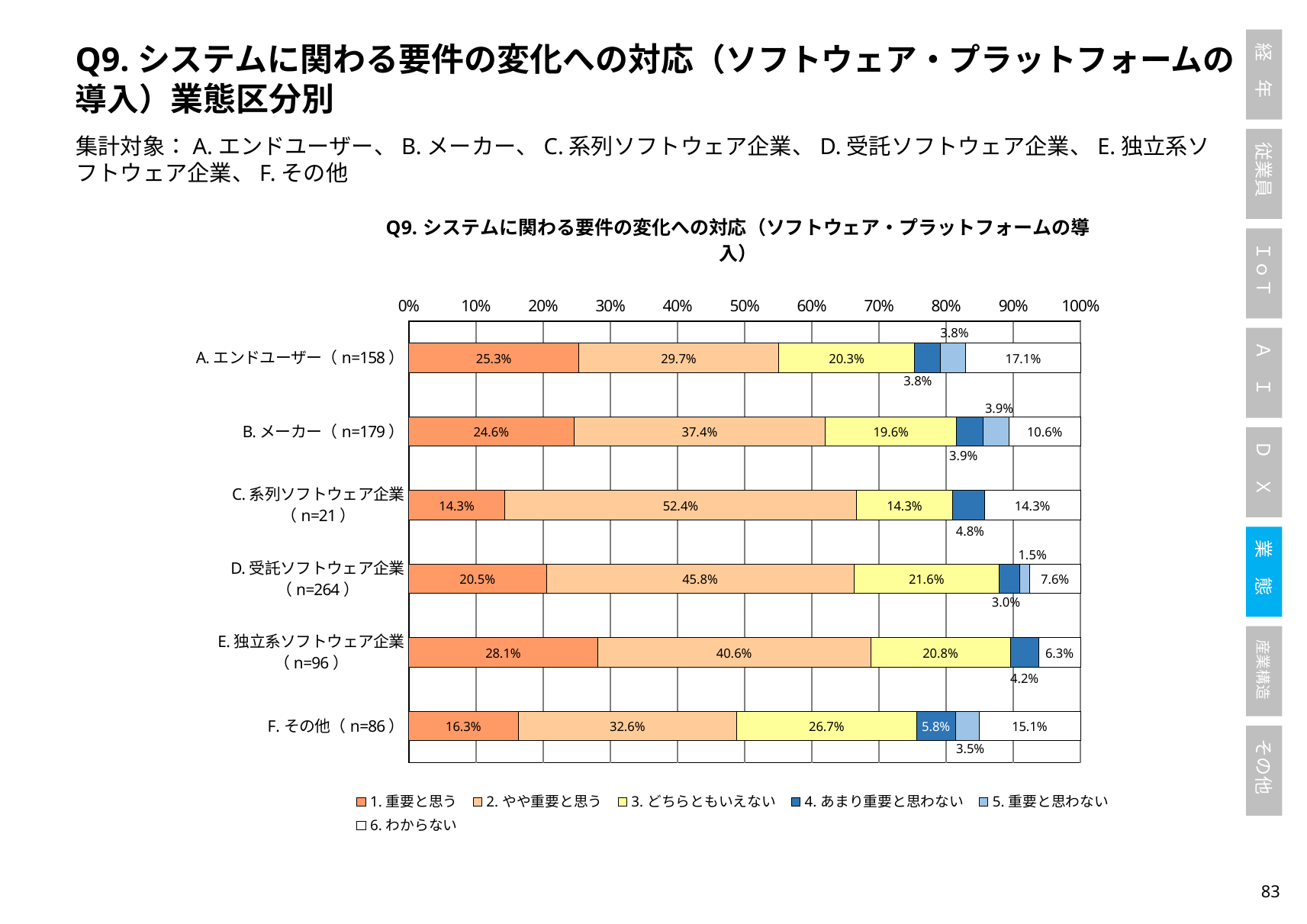
What is the value of 「2. やや重要と思う」 for C. 系列ソフトウェア企業 (n=21)? 52.4% What is the value of 「1. 重要と思う」 for A. エンドユーザー (n=158)? 25.3% How many series does the legend list? 6 Which category has the highest value for 「1. 重要と思う」? E. 独立系ソフトウェア企業 (n=96) What is the value of 「4. あまり重要と思わない」 for F. その他 (n=86)? 5.8% What is the sample size (n) shown for B. メーカー? 179 What is the value of 「6. わからない」 for D. 受託ソフトウェア企業 (n=264)? 7.6% Which category has the lowest value for 「6. わからない」? E. 独立系ソフトウェア企業 (n=96) Which is larger: the 「3. どちらともいえない」 value for F. その他 or for D. 受託ソフトウェア企業? F. その他 How many business categories are plotted on the chart? 6 What kind of chart is shown on the slide? Stacked bar chart What is the difference between the 「2. やや重要と思う」 values for B. メーカー and A. エンドユーザー? 7.7%